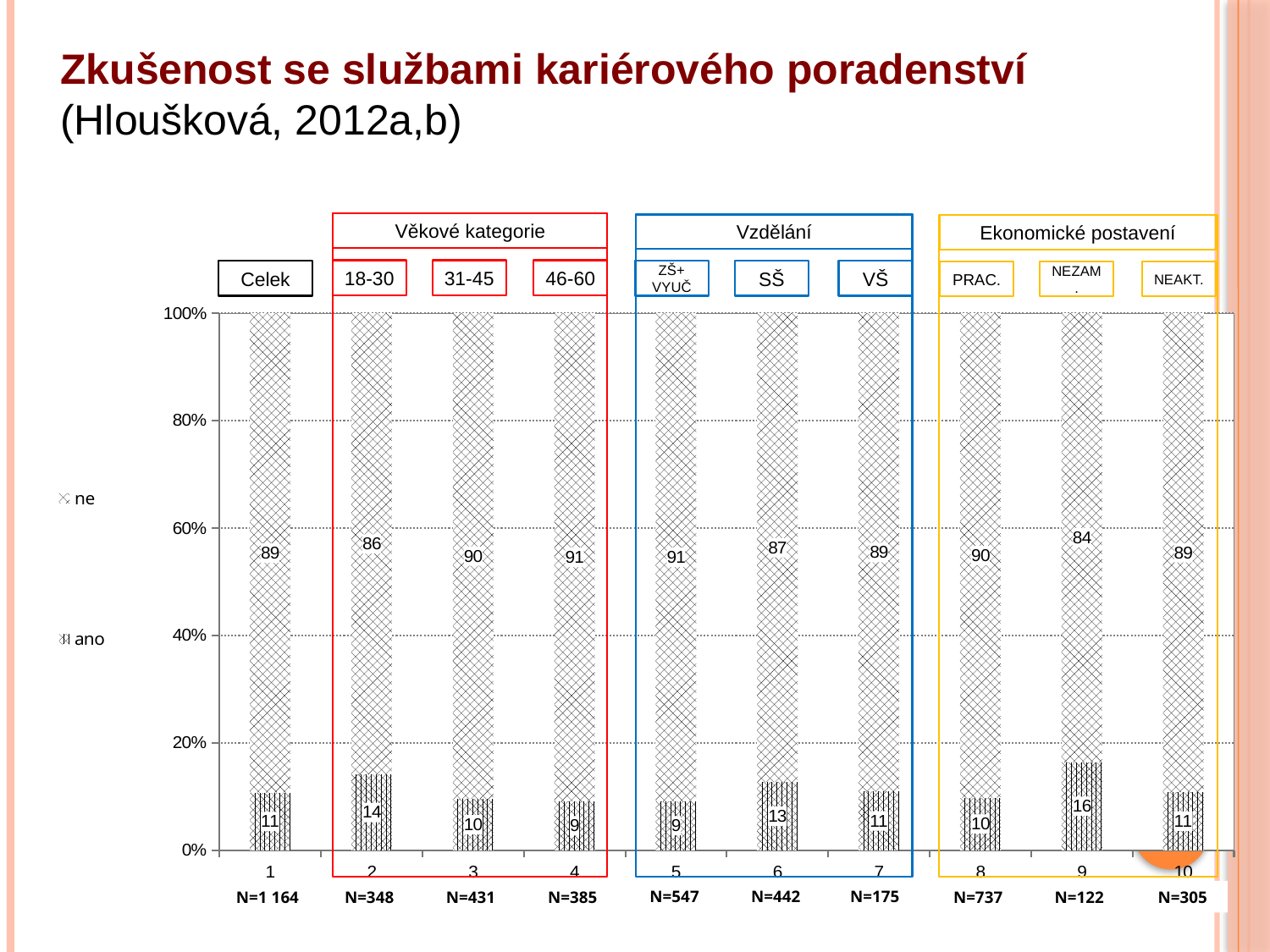
How many categories (bars) are plotted in the chart? 10 How many series does the legend list? 2 What type of chart is shown on the slide? stacked bar chart What is the value of "ano" for the NEZAM. category? 16 What is the difference between the "ano" values for 18-30 and 46-60? 5 What is the total of the stacked bar for the PRAC. category? 100 What is the sample size (N) shown for the Celek category? N=1 164 Which category has the lowest "ne" value? NEZAM. What is the value of "ano" for the Celek category? 11 What is the value of "ne" for the 18-30 age category? 86 Which category has the highest "ano" value? NEZAM. Which has a larger "ano" value, SŠ or VŠ? SŠ